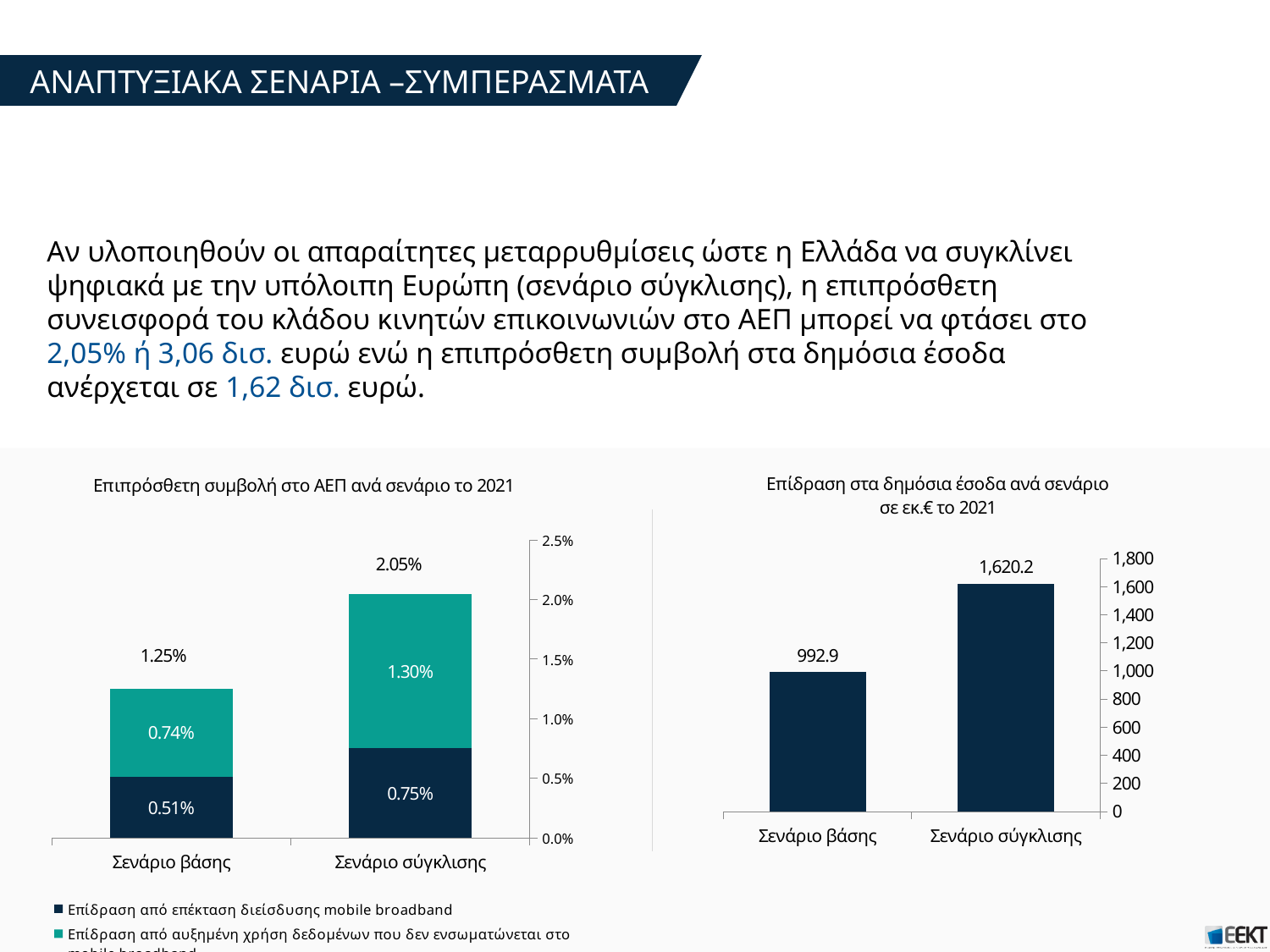
In the chart 'Επίδραση στα δημόσια έσοδα ανά σενάριο σε εκ.€ το 2021', what is the value for Σενάριο βάσης? 992.9 What kind of chart is 'Επιπρόσθετη συμβολή στο ΑΕΠ ανά σενάριο το 2021'? Stacked bar chart In the chart 'Επιπρόσθετη συμβολή στο ΑΕΠ ανά σενάριο το 2021', what is the value of the 'Επίδραση από επέκταση διείσδυσης mobile broadband' segment for Σενάριο βάσης? 0.51% In the chart 'Επιπρόσθετη συμβολή στο ΑΕΠ ανά σενάριο το 2021', what is the total value of the stacked bar for Σενάριο βάσης? 1.25% In the chart 'Επιπρόσθετη συμβολή στο ΑΕΠ ανά σενάριο το 2021', what is the value of the upper (teal) segment for Σενάριο σύγκλισης? 1.30% In the chart 'Επιπρόσθετη συμβολή στο ΑΕΠ ανά σενάριο το 2021', what is the total value of the stacked bar for Σενάριο σύγκλισης? 2.05% In the chart 'Επίδραση στα δημόσια έσοδα ανά σενάριο σε εκ.€ το 2021', what is the difference between the value for Σενάριο σύγκλισης and the value for Σενάριο βάσης? 627.3 How many categories are shown on the x axis of the chart 'Επίδραση στα δημόσια έσοδα ανά σενάριο σε εκ.€ το 2021'? 2 How many series does the legend of the chart 'Επιπρόσθετη συμβολή στο ΑΕΠ ανά σενάριο το 2021' list? 2 In the chart 'Επιπρόσθετη συμβολή στο ΑΕΠ ανά σενάριο το 2021', what is the difference between the total for Σενάριο σύγκλισης and the total for Σενάριο βάσης? 0.80% In the chart 'Επίδραση στα δημόσια έσοδα ανά σενάριο σε εκ.€ το 2021', what is the value for Σενάριο σύγκλισης? 1,620.2 In the chart 'Επίδραση στα δημόσια έσοδα ανά σενάριο σε εκ.€ το 2021', which scenario has the higher value? Σενάριο σύγκλισης